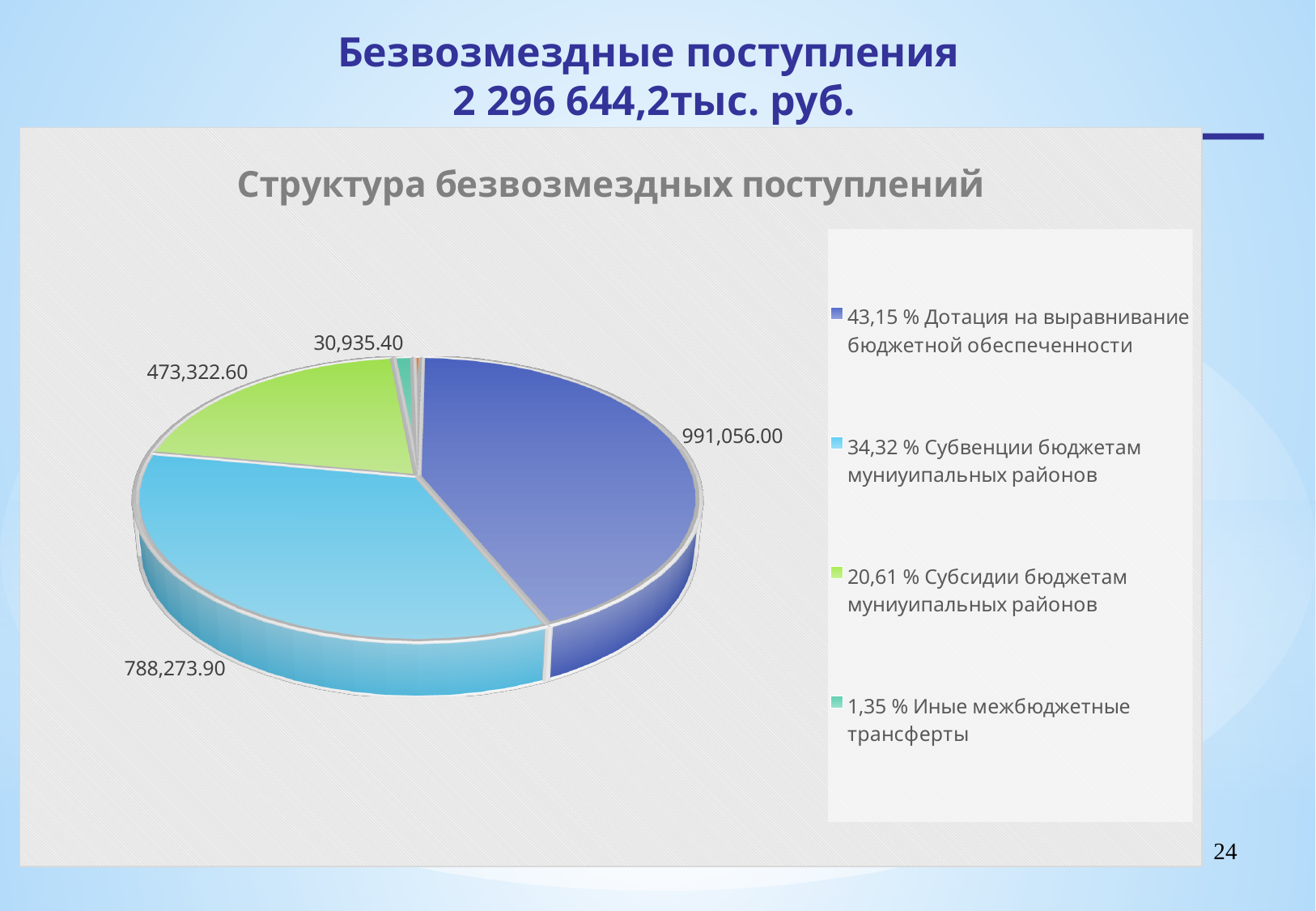
What is the value shown for Субвенции бюджетам муниуипальных районов? 788,273.90 What is the difference between the values for Дотация на выравнивание бюджетной обеспеченности and Субвенции бюджетам муниуипальных районов? 202,782.10 What share of the pie does Субвенции бюджетам муниуипальных районов represent, according to the legend? 34,32 % What is the title of the chart? Структура безвозмездных поступлений Which legend category has the smallest slice of the pie? Иные межбюджетные трансферты What is the value shown for Субсидии бюджетам муниуипальных районов? 473,322.60 How many entries does the chart legend list? 4 Which is larger: the value for Субсидии бюджетам муниуипальных районов or the value for Иные межбюджетные трансферты? Субсидии бюджетам муниуипальных районов What is the value shown for Дотация на выравнивание бюджетной обеспеченности? 991,056.00 Which category has the largest slice of the pie? Дотация на выравнивание бюджетной обеспеченности What is the value shown for Иные межбюджетные трансферты? 30,935.40 What kind of chart is shown on the slide? pie chart